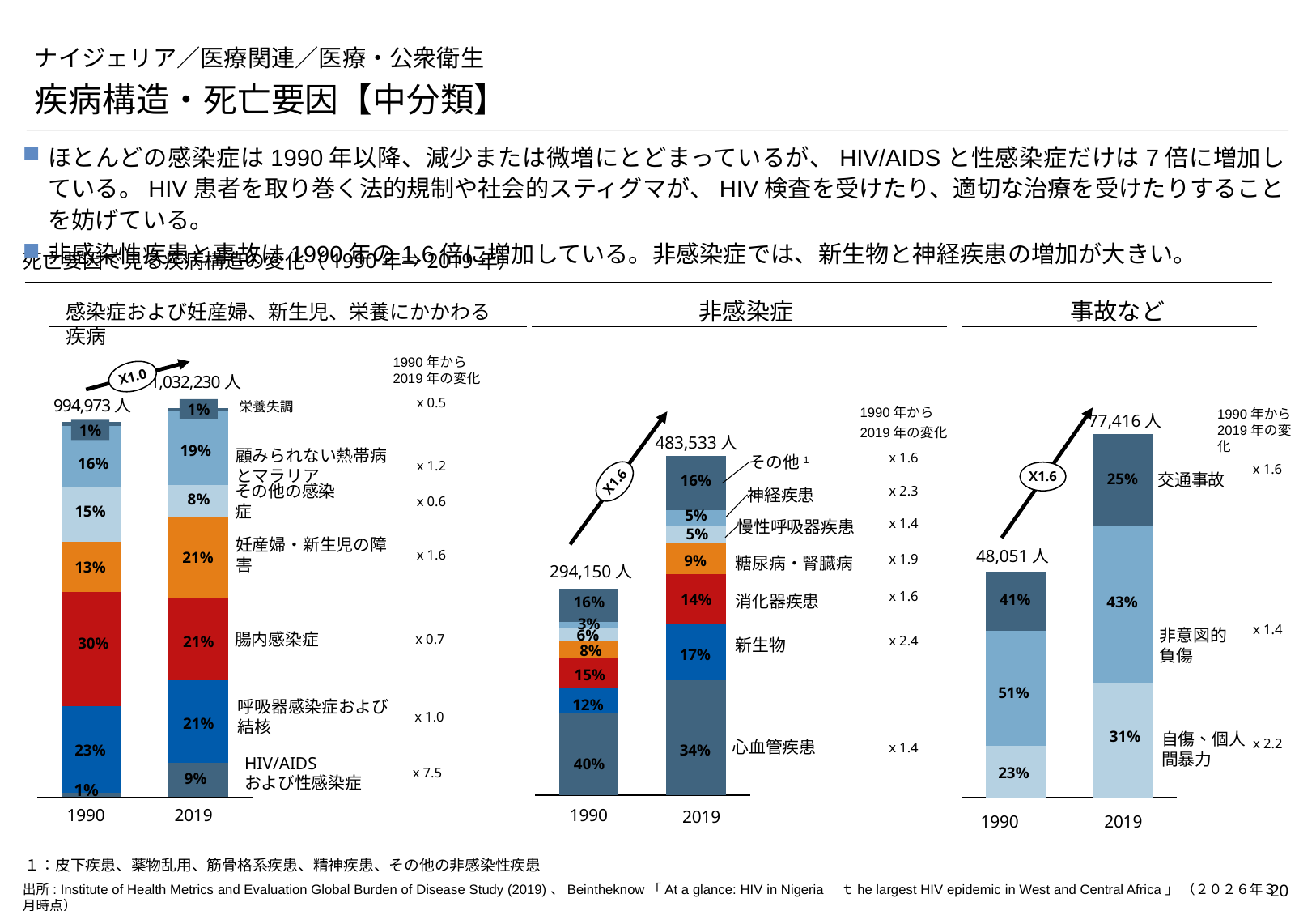
In the 感染症および妊産婦、新生児、栄養にかかわる疾病 chart, what is the 1990-to-2019 change multiplier shown for HIV/AIDSおよび性感染症? x 7.5 In the 非感染症 chart, which category has the largest share in 2019? 心血管疾患 In the 事故など chart, what is the total number of deaths shown for 2019? 77,416人 In the 非感染症 chart, which category has the highest 1990-to-2019 change multiplier? 新生物 (x 2.4) In the 感染症および妊産婦、新生児、栄養にかかわる疾病 chart, by how many percentage points did the share of 腸内感染症 fall from 1990 to 2019? 9 percentage points In the 事故など chart, which category has the largest share in 2019? 非意図的負傷 In the 感染症および妊産婦、新生児、栄養にかかわる疾病 chart, what is the total number of deaths shown for 2019? 1,032,230人 In the 非感染症 chart, what is the total number of deaths shown for 1990? 294,150人 What kind of chart is used on this slide to show the disease structure? Stacked bar chart In the 事故など chart, is the 2019 share of 交通事故 larger or smaller than the 2019 share of 自傷・個人間暴力? smaller In the 感染症および妊産婦、新生児、栄養にかかわる疾病 chart, what percentage does 腸内感染症 account for in 1990? 30% In the 非感染症 chart, what percentage does 新生物 account for in 2019? 17%